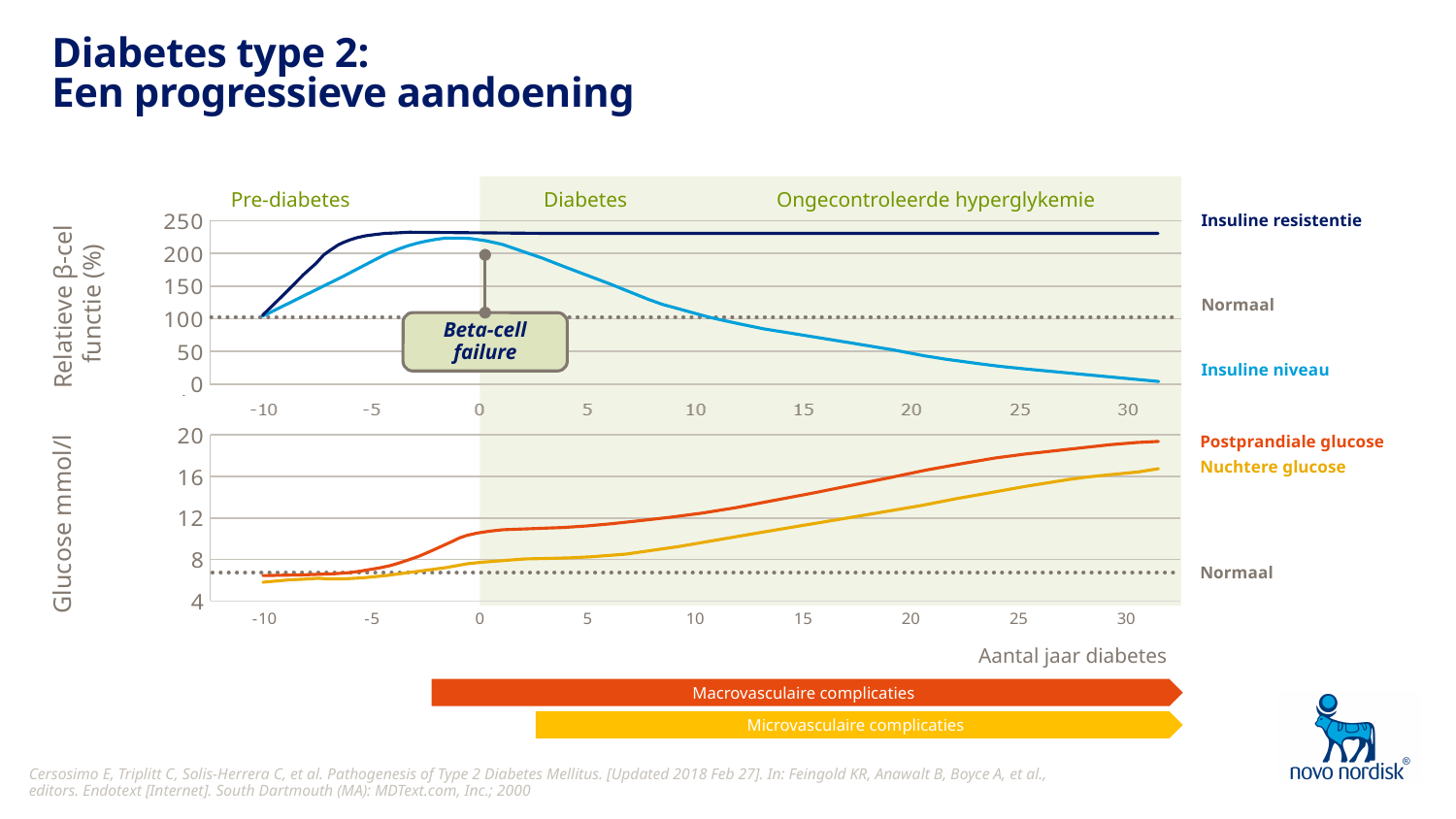
What kind of chart is used on this slide to show insulin and glucose over the years of diabetes? line chart In the bottom chart (Glucose mmol/l), which is higher at year 30: Postprandiale glucose or Nuchtere glucose? Postprandiale glucose What is the label of the shared x axis of the charts? Aantal jaar diabetes In the top chart (Relatieve β-cel functie), at what value does the dotted Normaal line sit? 100 In the bottom chart (Glucose mmol/l), is the Nuchtere glucose value at year 0 greater or less than 12? less In the bottom chart (Glucose mmol/l), is the Postprandiale glucose value at year 30 greater or less than 16? greater In the top chart (Relatieve β-cel functie), does the Insuline niveau line rise or fall after year 0? fall In the top chart (Relatieve β-cel functie), is the Insuline niveau value at year 30 greater or less than 50? less In the top chart (Relatieve β-cel functie), does the Insuline resistentie line rise or fall between year -10 and year 0? rise In the bottom chart (Glucose mmol/l), does the Postprandiale glucose line rise or fall from year 0 to year 30? rise In the top chart (Relatieve β-cel functie), which is higher at year 20: Insuline resistentie or Insuline niveau? Insuline resistentie